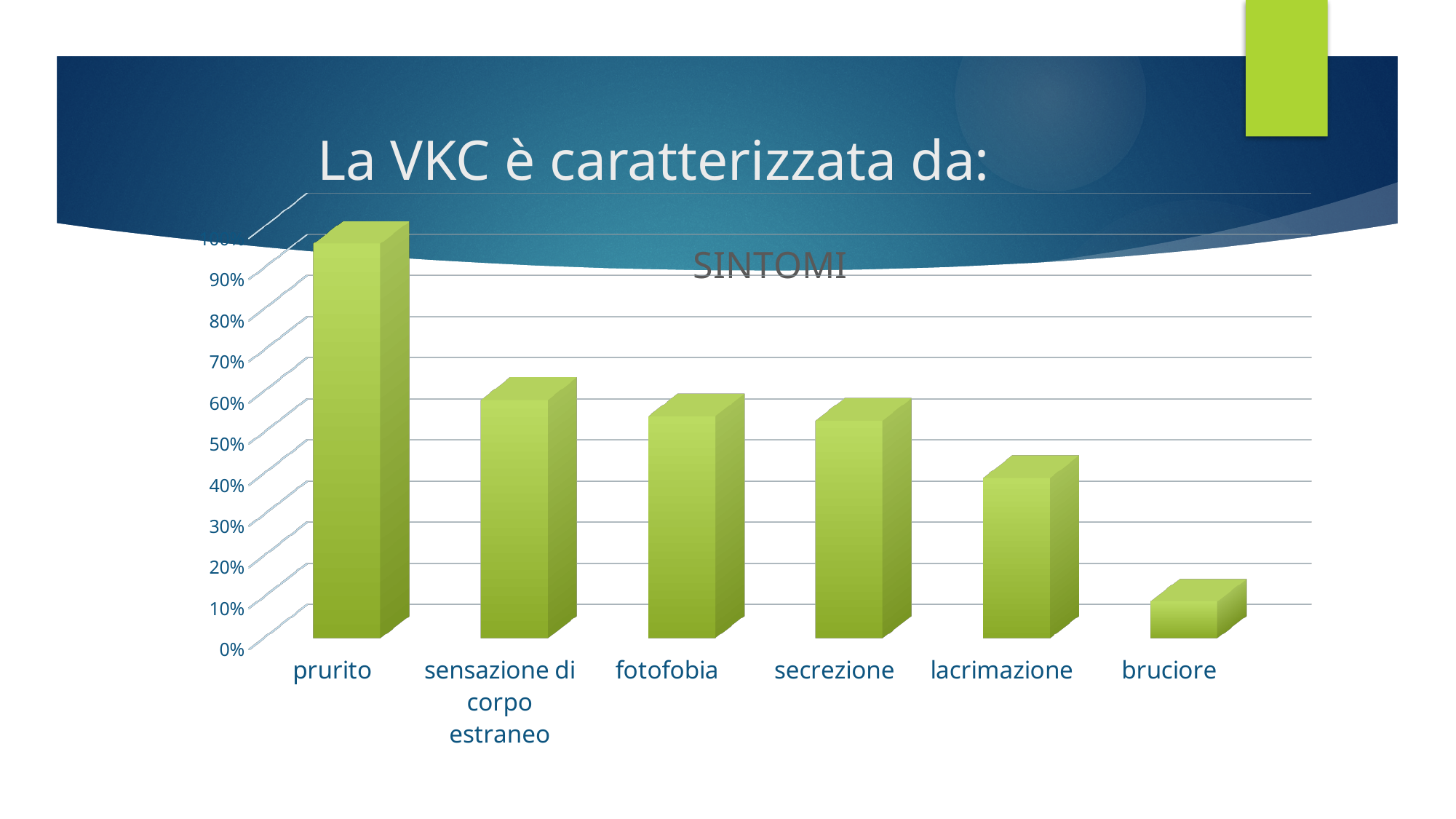
What is the title of the chart? SINTOMI How many categories are shown on the x axis of the chart? 6 Which category has the lowest value? bruciore Is the value for prurito greater or less than 90%? greater What colour are the bars in the chart? green Is the value for lacrimazione greater or less than 50%? less Do the values rise or fall moving from left to right along the x axis? fall Which category has the highest value? prurito Which is larger, the value for sensazione di corpo estraneo or the value for lacrimazione? sensazione di corpo estraneo Is the value for bruciore greater or less than 20%? less What kind of chart is shown on the slide? bar chart